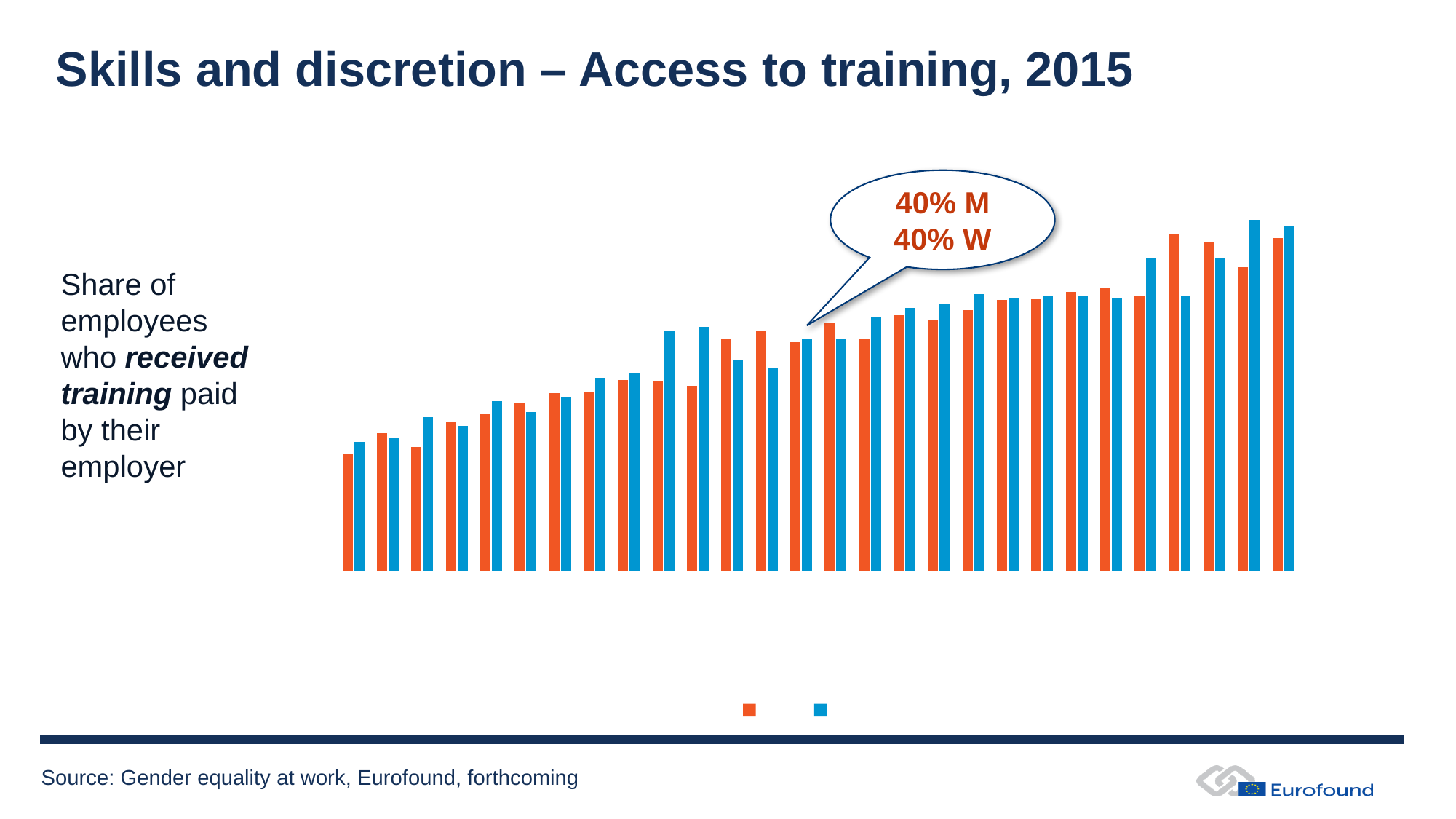
Is the shortest bar in the chart orange or blue? orange What share for W (women) does the callout on the chart give? 40% How many series does the legend show? 2 What kind of chart is shown on the slide? bar chart Is the tallest bar in the chart orange or blue? blue What is the title of the slide containing the chart? Skills and discretion – Access to training, 2015 How many pairs of bars (categories) are plotted in the chart? 28 What two colours are used for the bars in the chart? orange and blue What share for M (men) does the callout on the chart give? 40% Do the bar heights generally rise or fall from left to right across the chart? rise